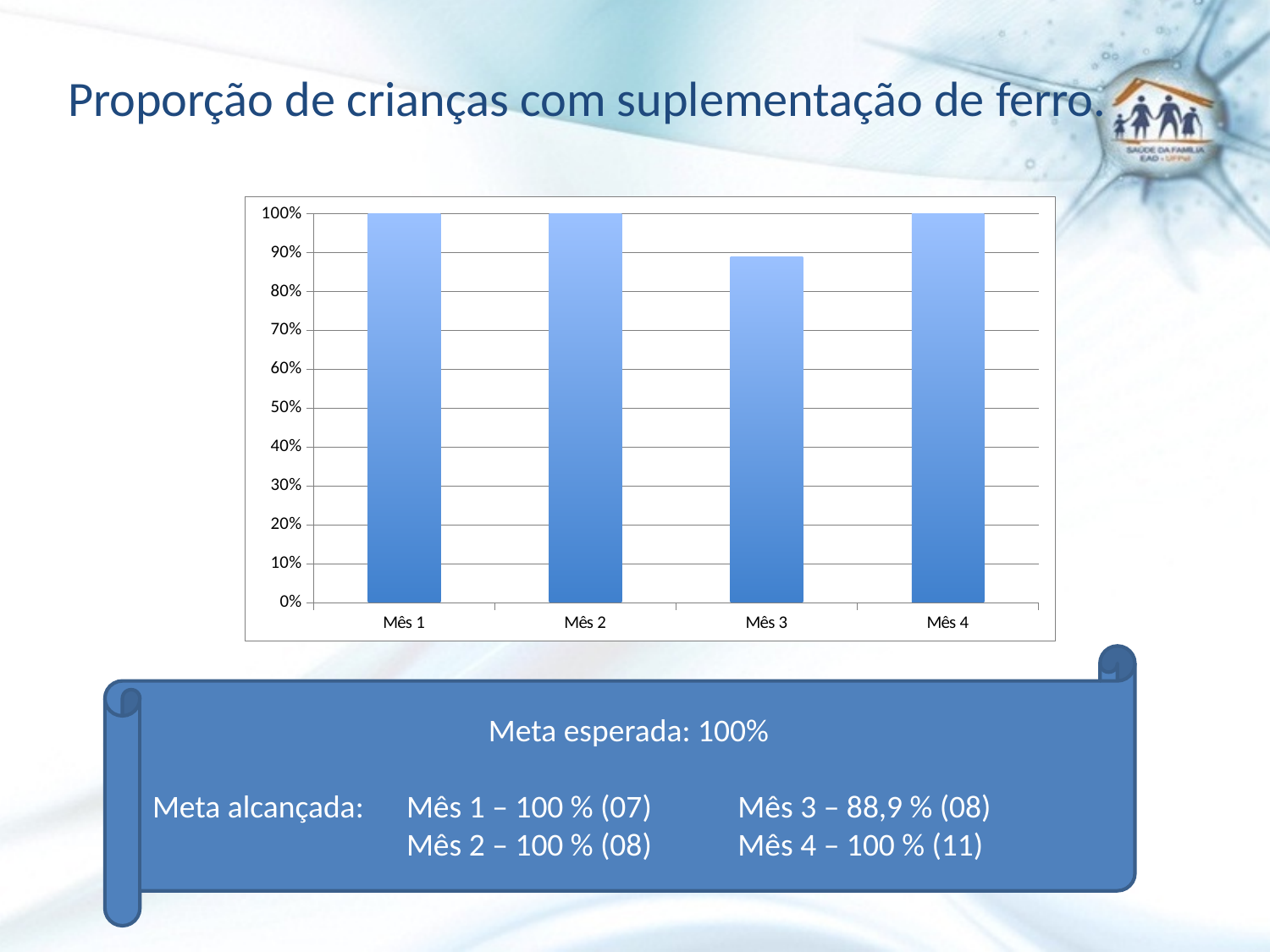
What is the expected target (meta esperada) stated on the slide? 100% What kind of chart is shown on the slide? bar chart What is the title of the slide containing the chart? Proporção de crianças com suplementação de ferro. What is the value for Mês 2 in the chart? 100% Which month has the lowest value in the chart? Mês 3 According to the slide, what proportion was reached in Mês 3? 88,9 % Is the value for Mês 3 greater or less than 80%? greater Which is larger, the value for Mês 2 or the value for Mês 3? Mês 2 Is the value for Mês 3 greater or less than 90%? less What is the value for Mês 1 in the chart? 100% What is the value for Mês 4 in the chart? 100% How many months (categories) are shown on the x axis of the chart? 4